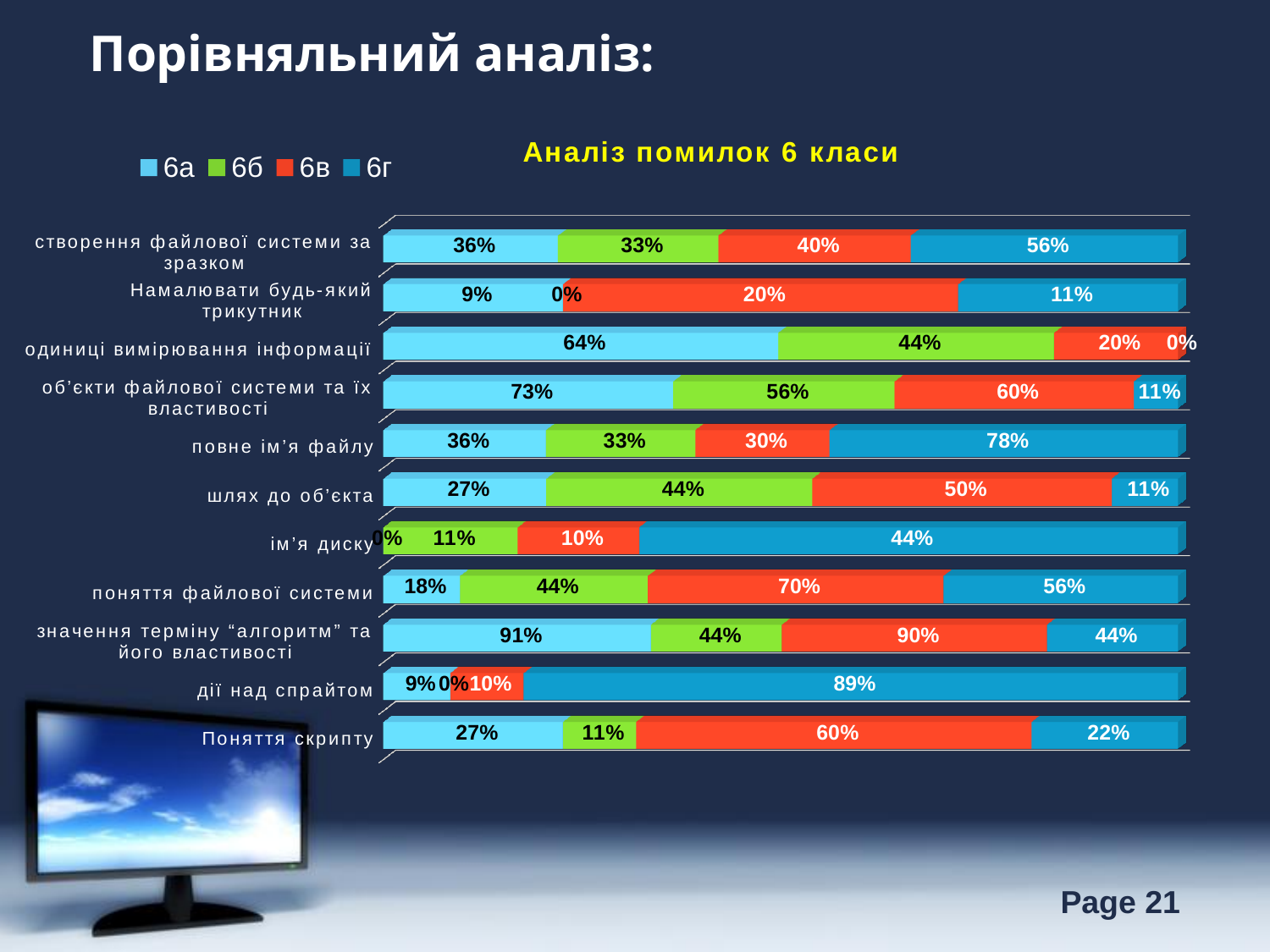
How many series does the legend list? 4 What is the difference between the 6в and 6а values in the category 'Поняття скрипту'? 33% Which category has the highest value for 6г? дії над спрайтом Which category has the highest value for 6а? значення терміну “алгоритм” та його властивості What is the value for 6г in the category 'повне ім'я файлу'? 78% What is the value for 6в in the category 'поняття файлової системи'? 70% In the category 'шлях до об'єкта', which is larger: the value for 6б or the value for 6в? 6в What type of chart is shown on the slide? bar chart What is the value for 6а in the category 'значення терміну “алгоритм” та його властивості'? 91% What is the value for 6б in the category 'Намалювати будь-який трикутник'? 0% What is the title of the chart? Аналіз помилок 6 класи How many categories are shown on the chart? 11